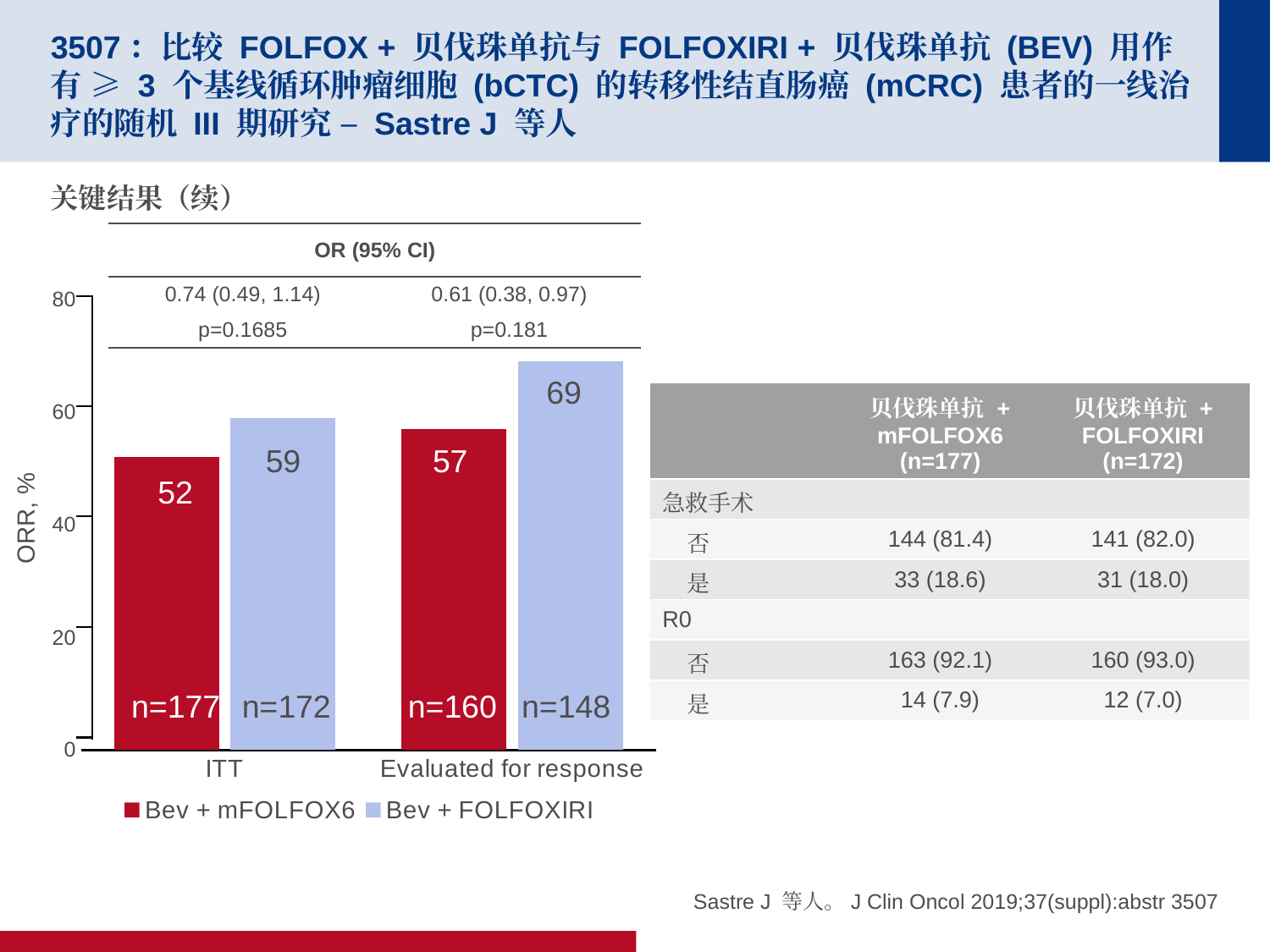
What is the difference in ORR between Bev + FOLFOXIRI and Bev + mFOLFOX6 in the Evaluated for response group? 12 In the ITT group, which treatment has the higher ORR, Bev + mFOLFOX6 or Bev + FOLFOXIRI? Bev + FOLFOXIRI Which bar in the chart has the highest ORR? Bev + FOLFOXIRI, Evaluated for response Which bar in the chart has the lowest ORR? Bev + mFOLFOX6, ITT What is the ORR for Bev + mFOLFOX6 in the ITT group? 52 What kind of chart is shown on the slide? Bar chart What is the difference in ORR between Bev + FOLFOXIRI and Bev + mFOLFOX6 in the ITT group? 7 What is the label of the y axis of the chart? ORR, % What is the ORR for Bev + FOLFOXIRI among patients evaluated for response? 69 What is the ORR for Bev + FOLFOXIRI in the ITT group? 59 How many series does the chart legend list? 2 What is the ORR for Bev + mFOLFOX6 among patients evaluated for response? 57